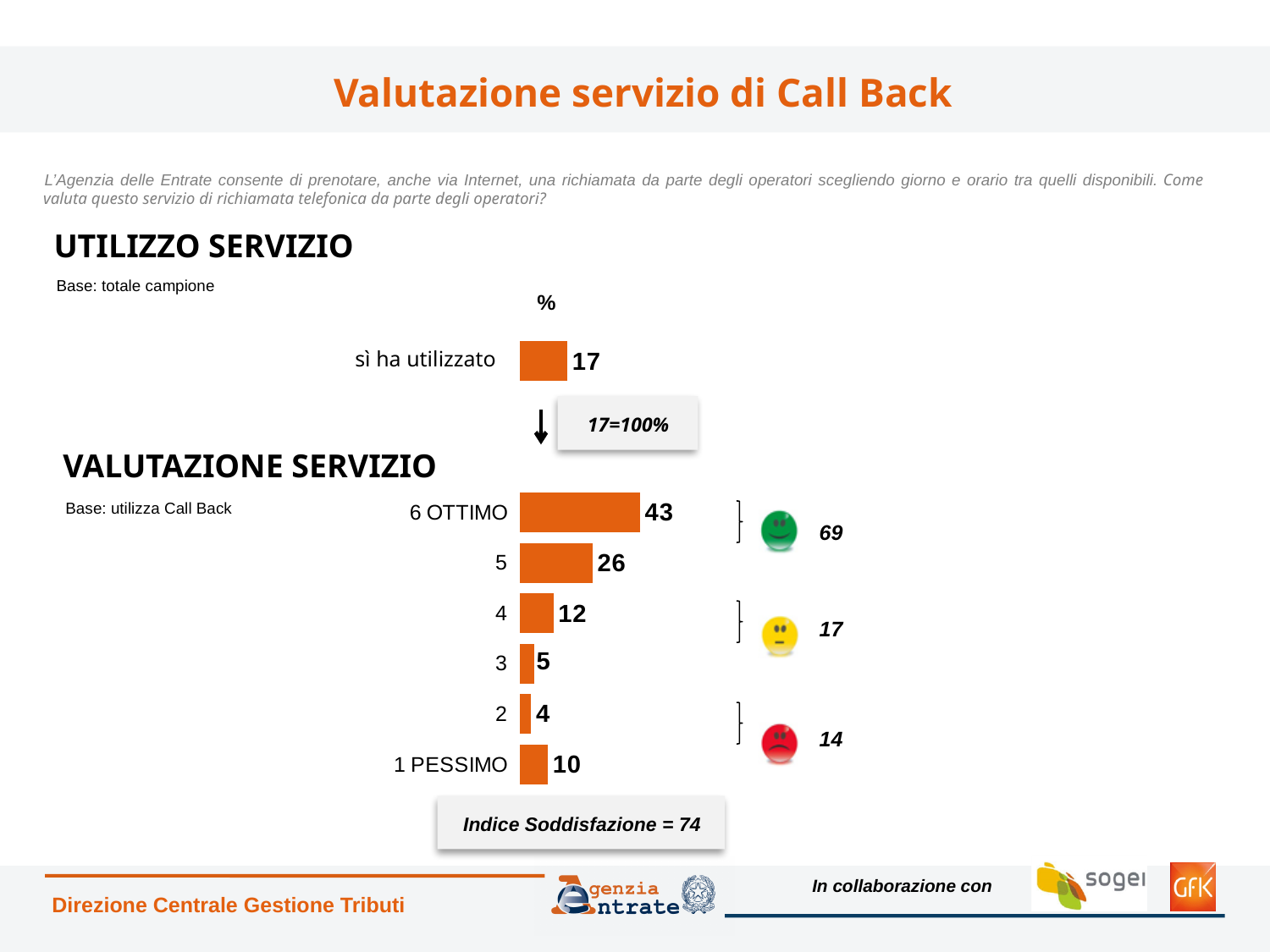
In the VALUTAZIONE SERVIZIO chart, which rating category has the highest value? 6 OTTIMO What is the value of the "Indice Soddisfazione" shown below the VALUTAZIONE SERVIZIO chart? 74 In the VALUTAZIONE SERVIZIO chart, what is the value for "1 PESSIMO"? 10 How many rating categories are shown in the VALUTAZIONE SERVIZIO chart? 6 In the VALUTAZIONE SERVIZIO chart, which is larger, the value for rating 3 or the value for "1 PESSIMO"? 1 PESSIMO In the VALUTAZIONE SERVIZIO chart, what is the difference between the values for "6 OTTIMO" and rating 5? 17 In the VALUTAZIONE SERVIZIO chart, what is the value for "6 OTTIMO"? 43 What kind of chart is the VALUTAZIONE SERVIZIO chart? bar chart In the VALUTAZIONE SERVIZIO chart, what is the value for rating 4? 12 In the VALUTAZIONE SERVIZIO chart, which rating category has the lowest value? 2 In the VALUTAZIONE SERVIZIO chart, what is the combined value shown next to the green smiley for ratings 6 and 5? 69 In the UTILIZZO SERVIZIO chart, what is the value for "sì ha utilizzato"? 17